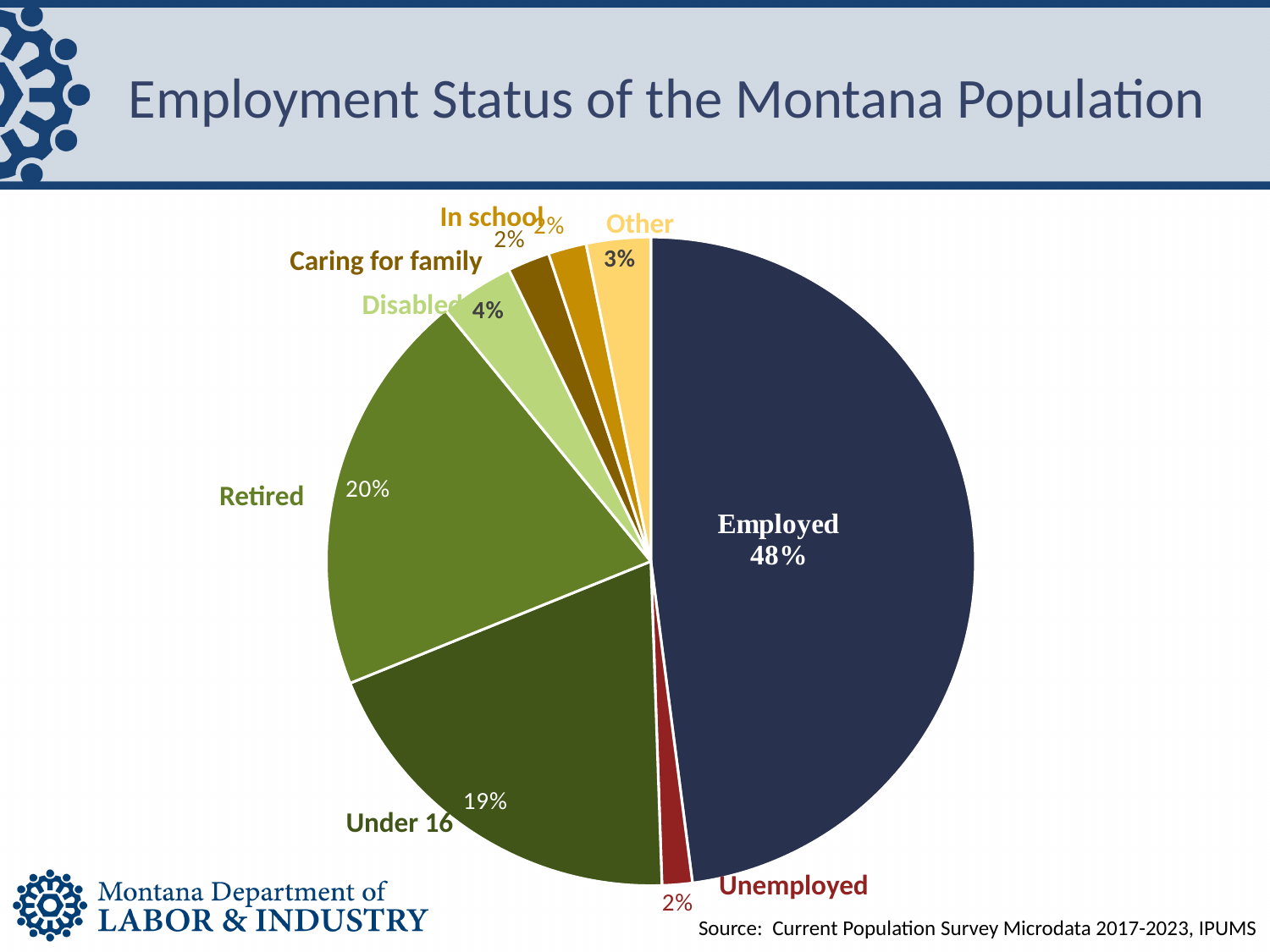
What share of the Montana population is Under 16? 19% What is the title of the chart? Employment Status of the Montana Population What share of the Montana population is Unemployed? 2% What is the difference between the Employed share and the Retired share? 28% What share of the Montana population is Retired? 20% What kind of chart is shown on the slide? pie chart What share of the Montana population is Disabled? 4% Which category has the largest share of the pie? Employed Which is larger, the Retired share or the Under 16 share? Retired What share of the Montana population falls under Other? 3% What share of the Montana population is Employed? 48% How many categories are shown in the pie chart? 8